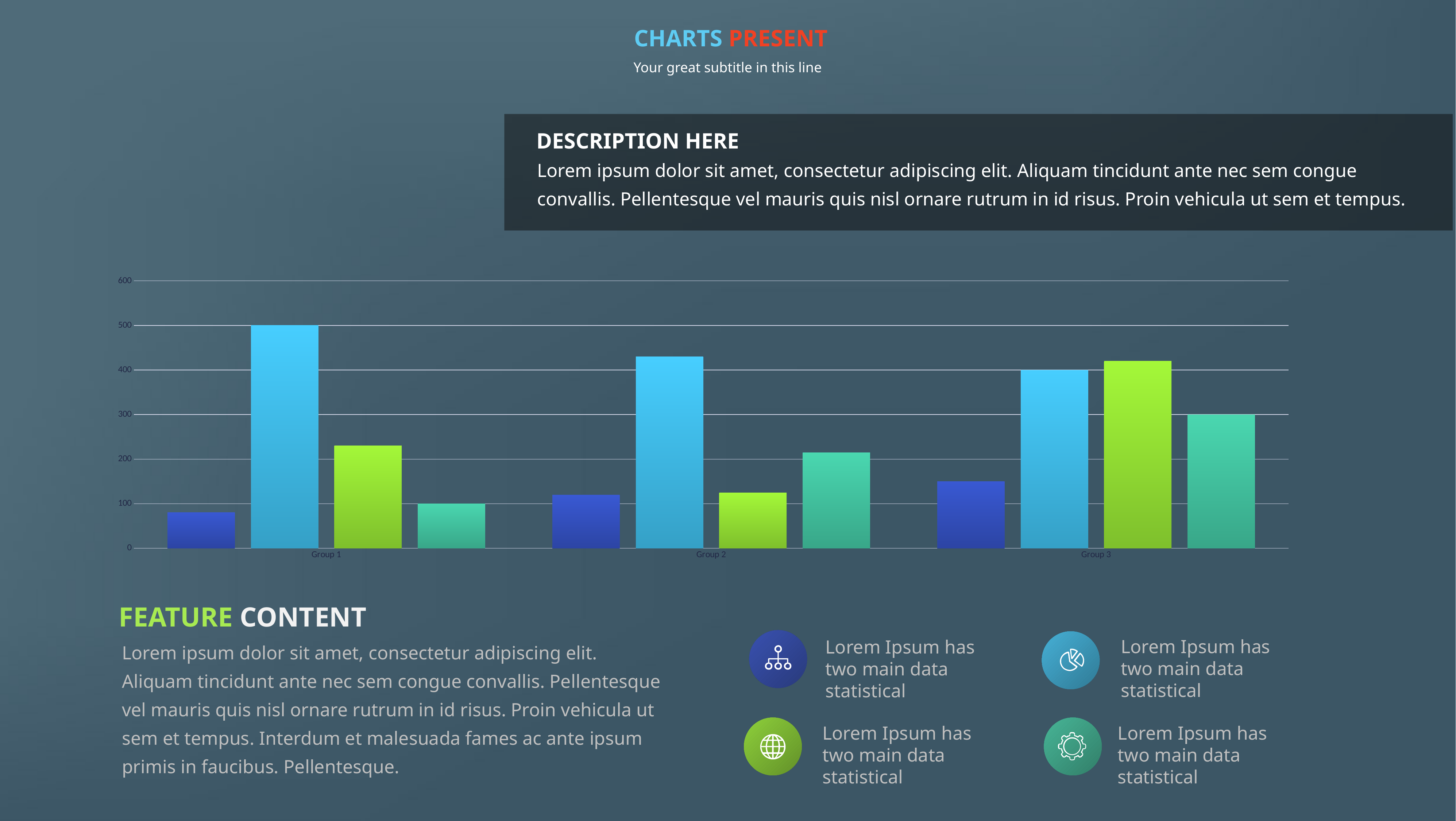
Is the value of the green bar for Group 2 greater or less than 200? less What is the value of the light blue bar for Group 3? 400 How many groups are shown on the x axis of the chart? 3 Which group contains the tallest bar in the chart? Group 1 Is the value of the dark blue bar for Group 1 greater or less than 100? less Which is larger in Group 2: the light blue bar or the teal bar? the light blue bar What kind of chart is shown on the slide? bar chart What is the value of the light blue bar for Group 1? 500 What is the value of the teal bar for Group 1? 100 How many bars are plotted for each group in the chart? 4 Do the dark blue bars rise or fall from Group 1 to Group 3? rise What is the value of the teal bar for Group 3? 300